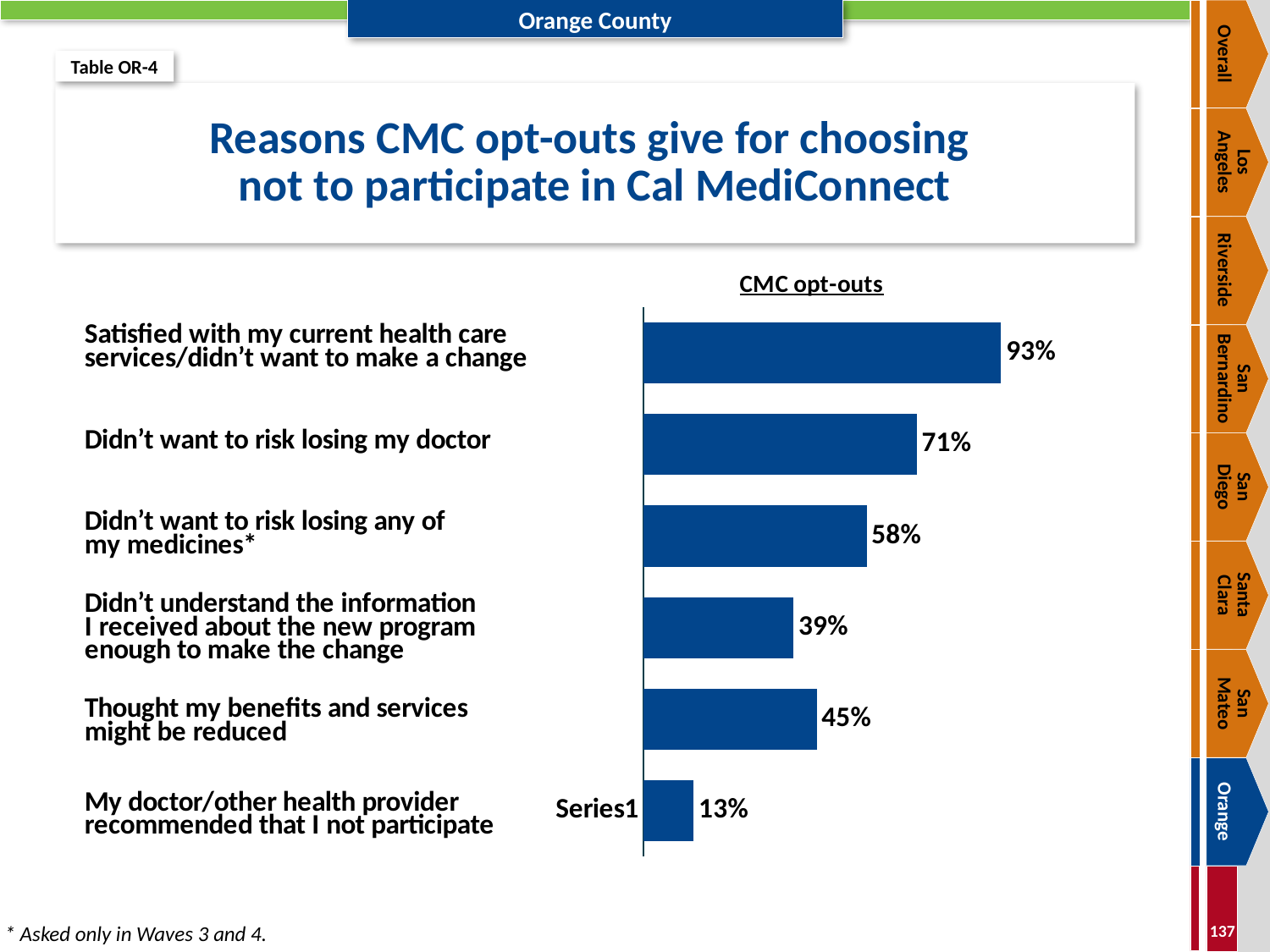
What percentage of CMC opt-outs said they didn't want to risk losing their doctor? 71% What percentage of CMC opt-outs said they didn't want to risk losing any of their medicines? 58% What is the label shown above the chart? CMC opt-outs Which reason has a higher percentage: 'Didn't understand the information I received about the new program enough to make the change' or 'Thought my benefits and services might be reduced'? Thought my benefits and services might be reduced What percentage of CMC opt-outs said their doctor/other health provider recommended that they not participate? 13% What percentage of CMC opt-outs said they thought their benefits and services might be reduced? 45% What percentage of CMC opt-outs said they were satisfied with their current health care services/didn't want to make a change? 93% What type of chart is shown on the slide? Bar chart What is the difference in percentage points between 'Didn't want to risk losing my doctor' and 'Didn't want to risk losing any of my medicines'? 13 How many reasons are shown in the chart? 6 Which reason has the highest percentage of CMC opt-outs? Satisfied with my current health care services/didn't want to make a change Which reason has the lowest percentage of CMC opt-outs? My doctor/other health provider recommended that I not participate